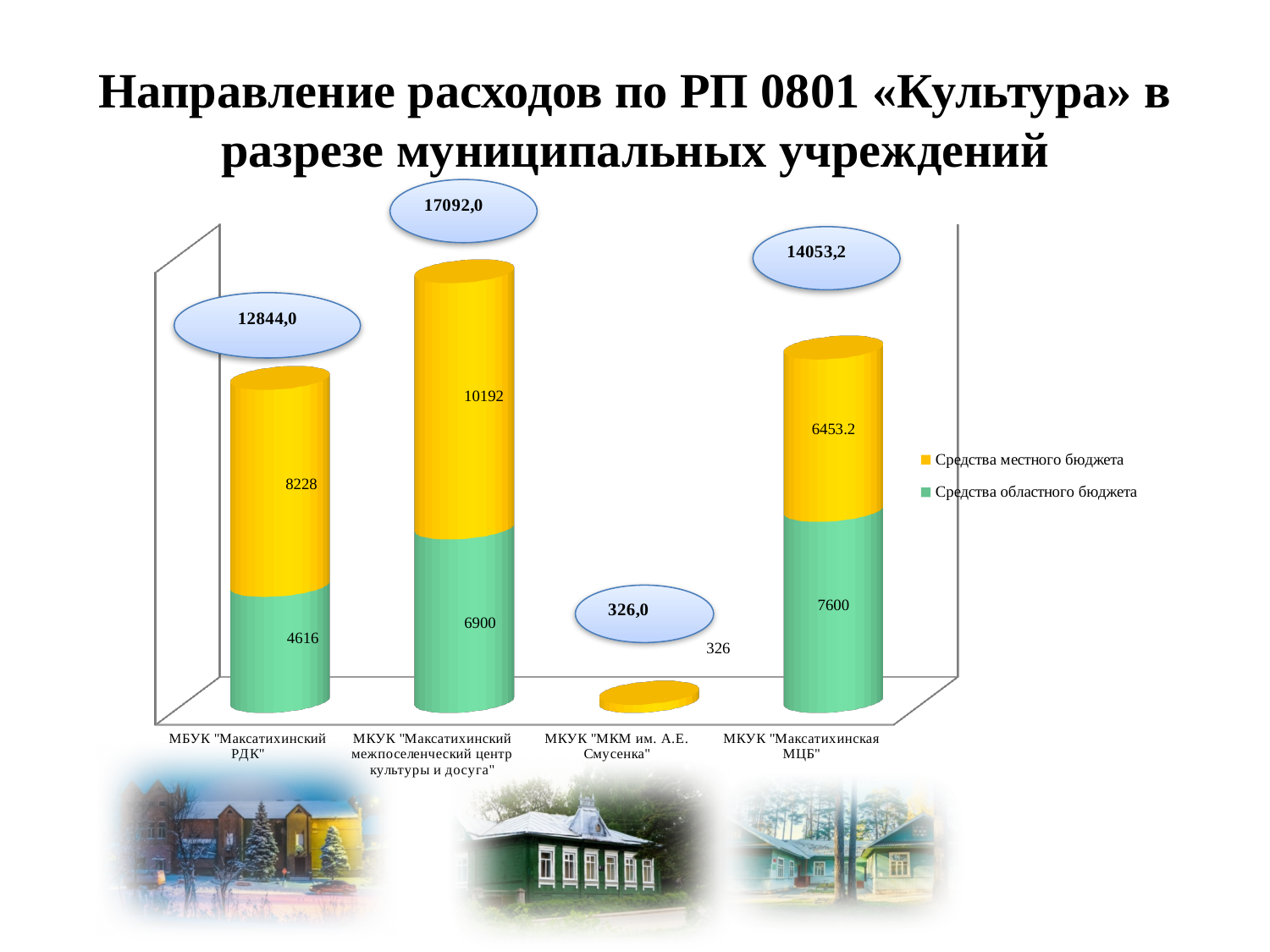
Which institution has the highest total expenditure? МКУК "Максатихинский межпоселенческий центр культуры и досуга" What total is shown in the callout above the bar for МКУК "МКМ им. А.Е. Смусенка"? 326,0 What is the value of "Средства областного бюджета" for МКУК "Максатихинский межпоселенческий центр культуры и досуга"? 6900 For МКУК "Максатихинская МЦБ", which is larger: "Средства местного бюджета" or "Средства областного бюджета"? Средства областного бюджета Which institution has the lowest total expenditure? МКУК "МКМ им. А.Е. Смусенка" Which colour represents "Средства областного бюджета" in the chart? Green What is the value of "Средства местного бюджета" for МБУК "Максатихинский РДК"? 8228 What type of chart is shown on the slide? Bar chart (stacked) How many institutions (categories) are shown on the x axis? 4 What is the value of "Средства местного бюджета" for МКУК "Максатихинская МЦБ"? 6453.2 How many series does the legend list? 2 What is the difference between the "Средства местного бюджета" values for МКУК "Максатихинский межпоселенческий центр культуры и досуга" and МБУК "Максатихинский РДК"? 1964